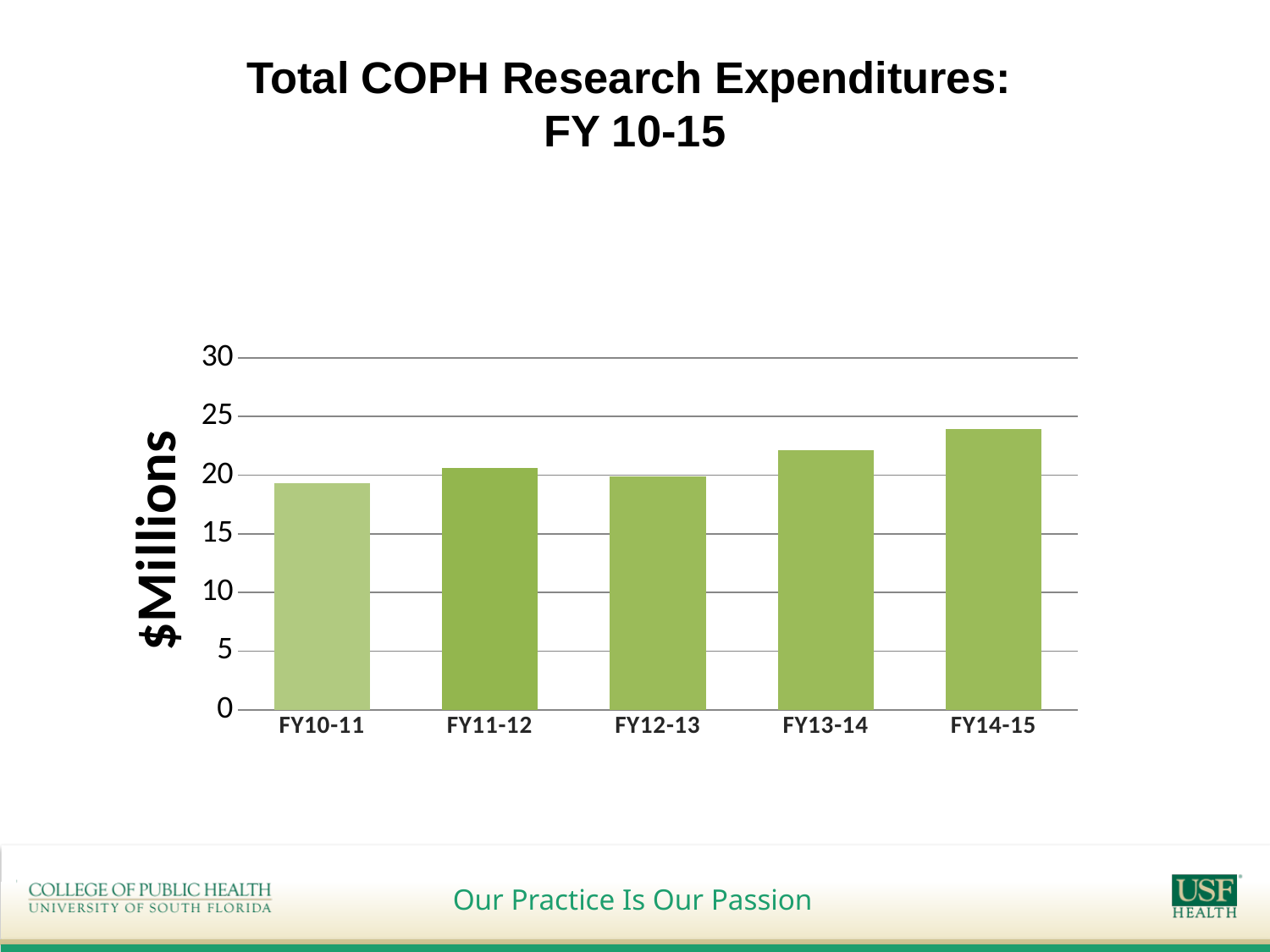
Which is larger, the value for FY14-15 or the value for FY13-14? FY14-15 Is the value for FY10-11 greater or less than 20? less What kind of chart is shown on the slide? bar chart How many fiscal years are shown on the x axis of the chart? 5 Is the value for FY13-14 greater or less than 20? greater What is the label on the y axis of the chart? $Millions Is the value for FY14-15 greater or less than 20? greater What is the title of the chart? Total COPH Research Expenditures: FY 10-15 Which fiscal year has the highest research expenditures? FY14-15 Is the value for FY14-15 higher or lower than the value for FY10-11? higher Which is larger, the value for FY13-14 or the value for FY11-12? FY13-14